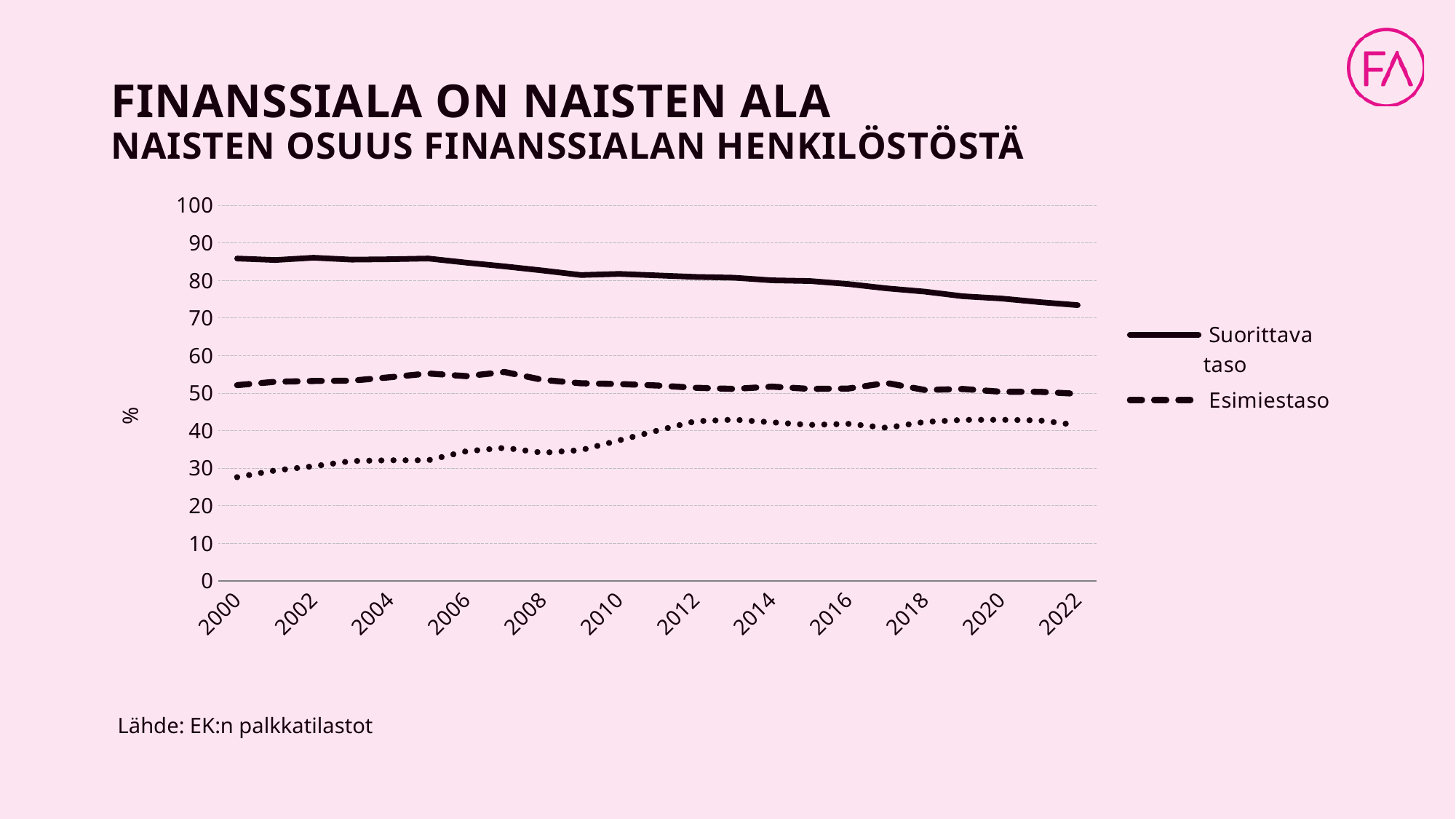
Is the value for Esimiestaso in 2022 greater or less than 60? less How many series does the legend list? 2 Is the value for Esimiestaso in 2006 greater or less than 50? greater Is the value for Suorittava taso in 2022 greater or less than 70? greater What is the main title of the slide? FINANSSIALA ON NAISTEN ALA How many year labels are shown on the x axis? 12 What source is cited for the chart? EK:n palkkatilastot In 2022, which is larger: Suorittava taso or Esimiestaso? Suorittava taso What kind of chart is shown on the slide? line chart Does the Suorittava taso line rise or fall from 2000 to 2022? fall